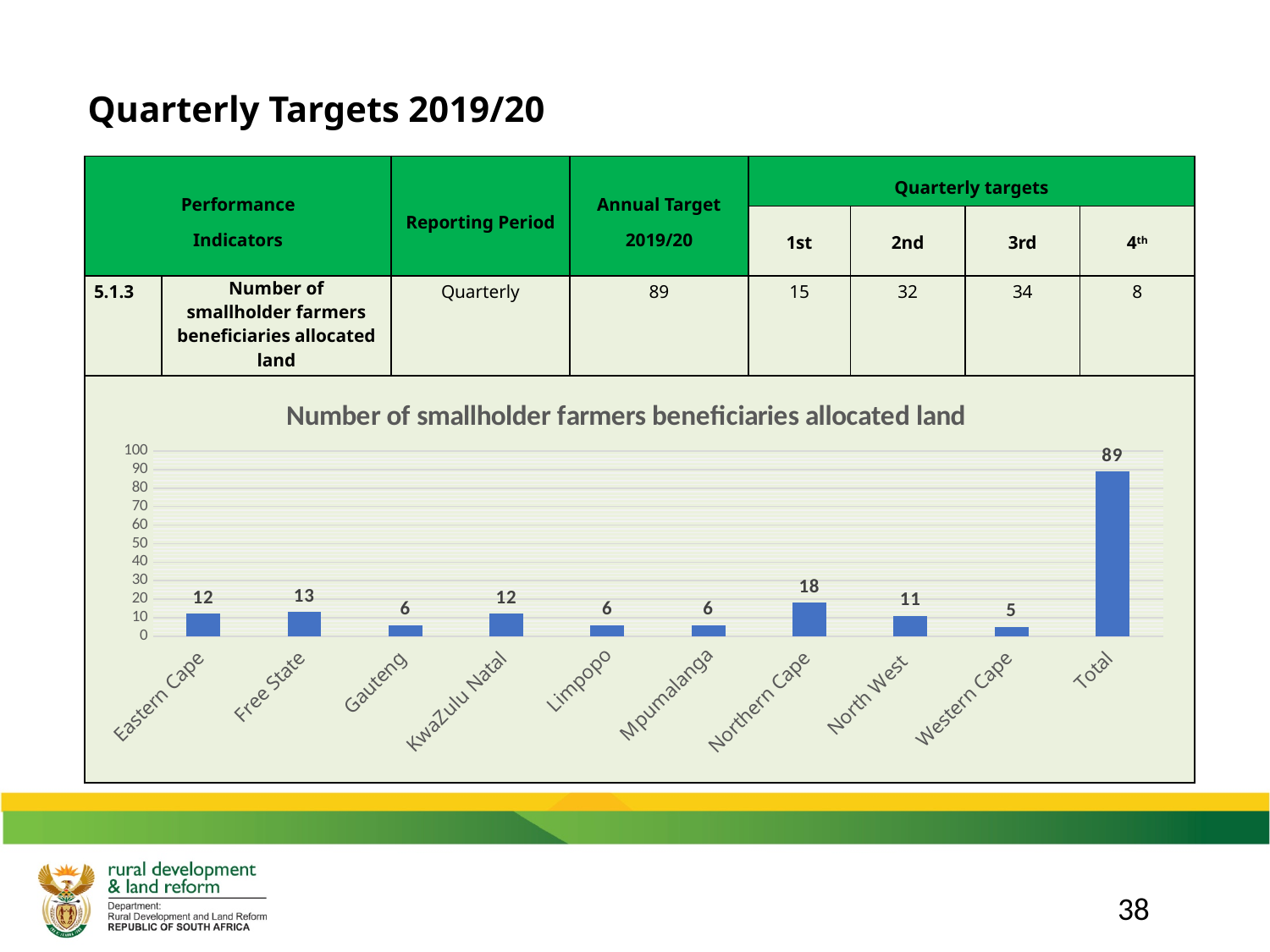
What is the value for Western Cape in the chart? 5 Excluding the Total bar, which province has the highest value in the chart? Northern Cape What is the value shown for the Total bar in the chart? 89 How many categories are shown on the x axis of the chart? 10 What is the title of the chart? Number of smallholder farmers beneficiaries allocated land Is the value for Total greater or less than 80? greater What is the value for Northern Cape in the chart? 18 Which has a larger value, Eastern Cape or Free State? Free State What is the difference between the values for Northern Cape and North West? 7 Which province has the lowest value in the chart? Western Cape What kind of chart is shown on the slide? bar chart What is the value for Free State in the chart? 13